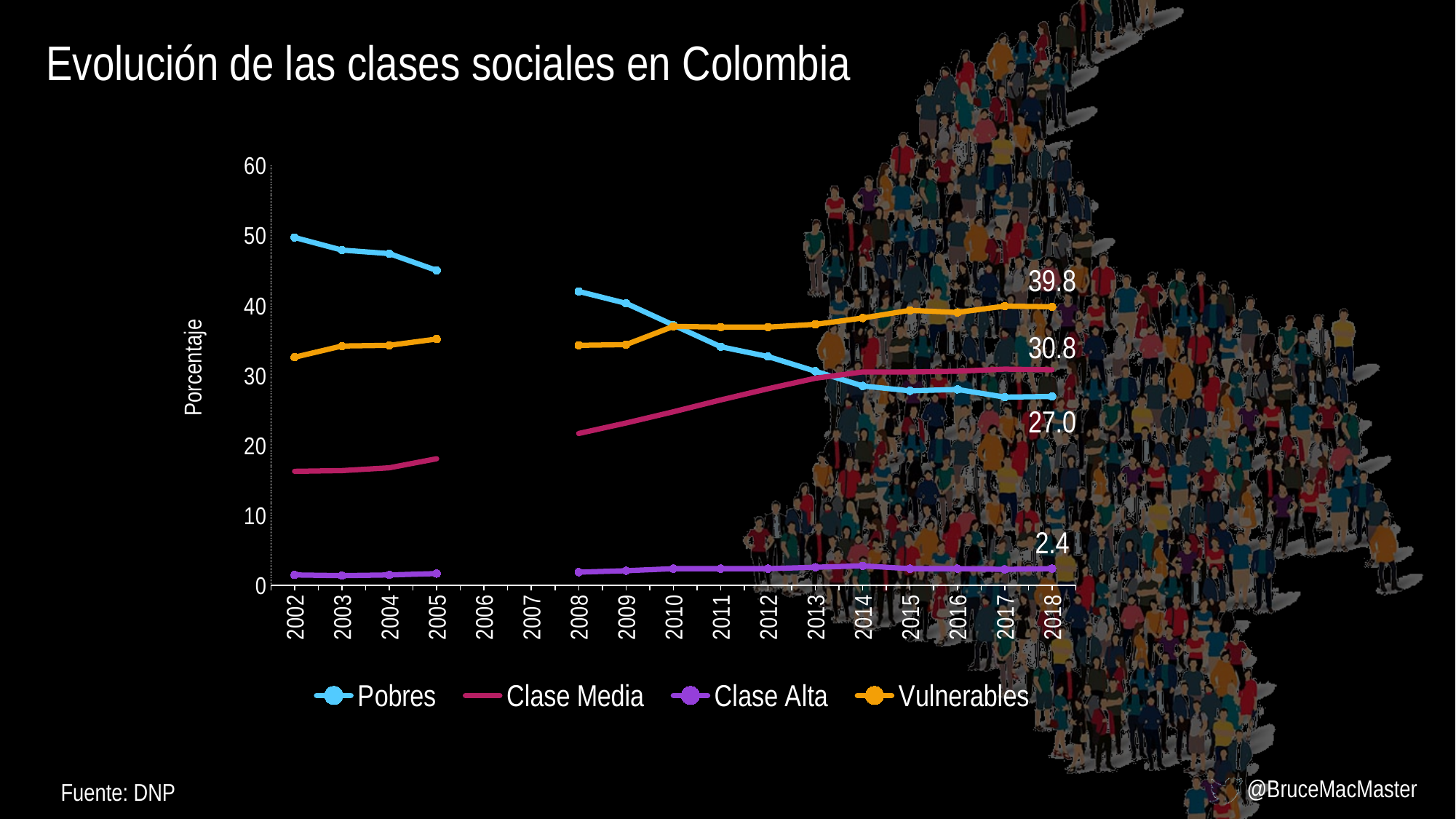
What is the value for Clase Media in 2018? 30.8 Does the Pobres series rise or fall from 2008 to 2018? fall Which series has the highest value in 2018? Vulnerables Is the value for Pobres in 2002 greater or less than 40? greater What is the value for Clase Alta in 2018? 2.4 What is the value for Pobres in 2018? 27.0 What kind of chart is shown on the slide? line chart In 2018, which is larger: Pobres or Clase Media? Clase Media How many series does the legend list? 4 Which series has the lowest value in 2018? Clase Alta What is the difference between the Vulnerables and Clase Media values in 2018? 9.0 What is the value for Vulnerables in 2018? 39.8